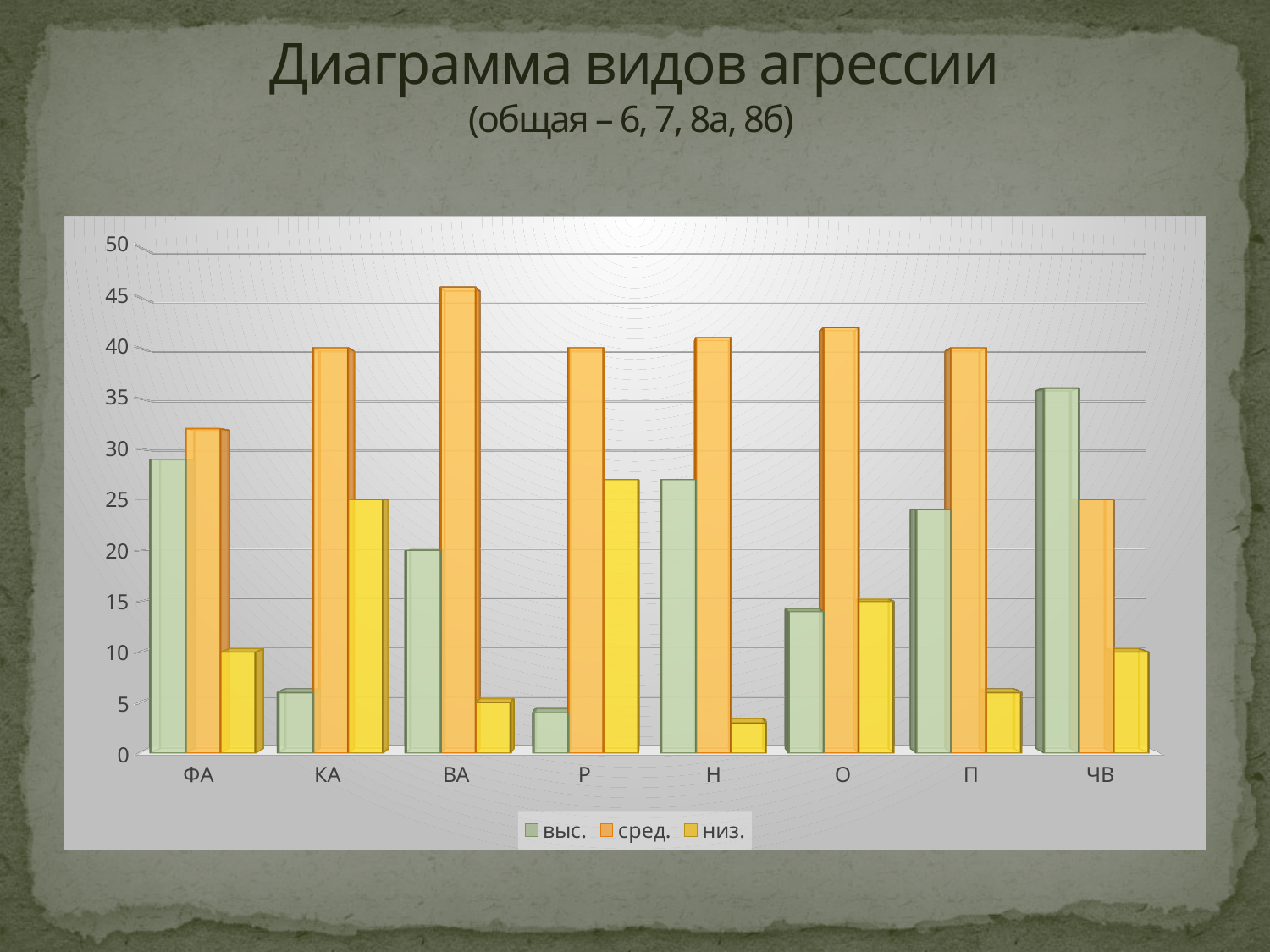
What kind of chart is shown on the slide? bar chart For category ЧВ, which is larger: выс. or сред.? выс. Which category has the highest value for the сред. series? ВА Is the value for выс. in category КА greater or less than 10? less What is the title of the chart on the slide? Диаграмма видов агрессии (общая – 6, 7, 8а, 8б) Is the value for сред. in category ВА greater or less than 40? greater How many categories are shown on the x axis of the chart? 8 Which category has the lowest value for the выс. series? Р Which category has the highest value for the выс. series? ЧВ For category Н, which is larger: выс. or низ.? выс. Is the value for низ. in category Р greater or less than 20? greater How many series does the legend list? 3